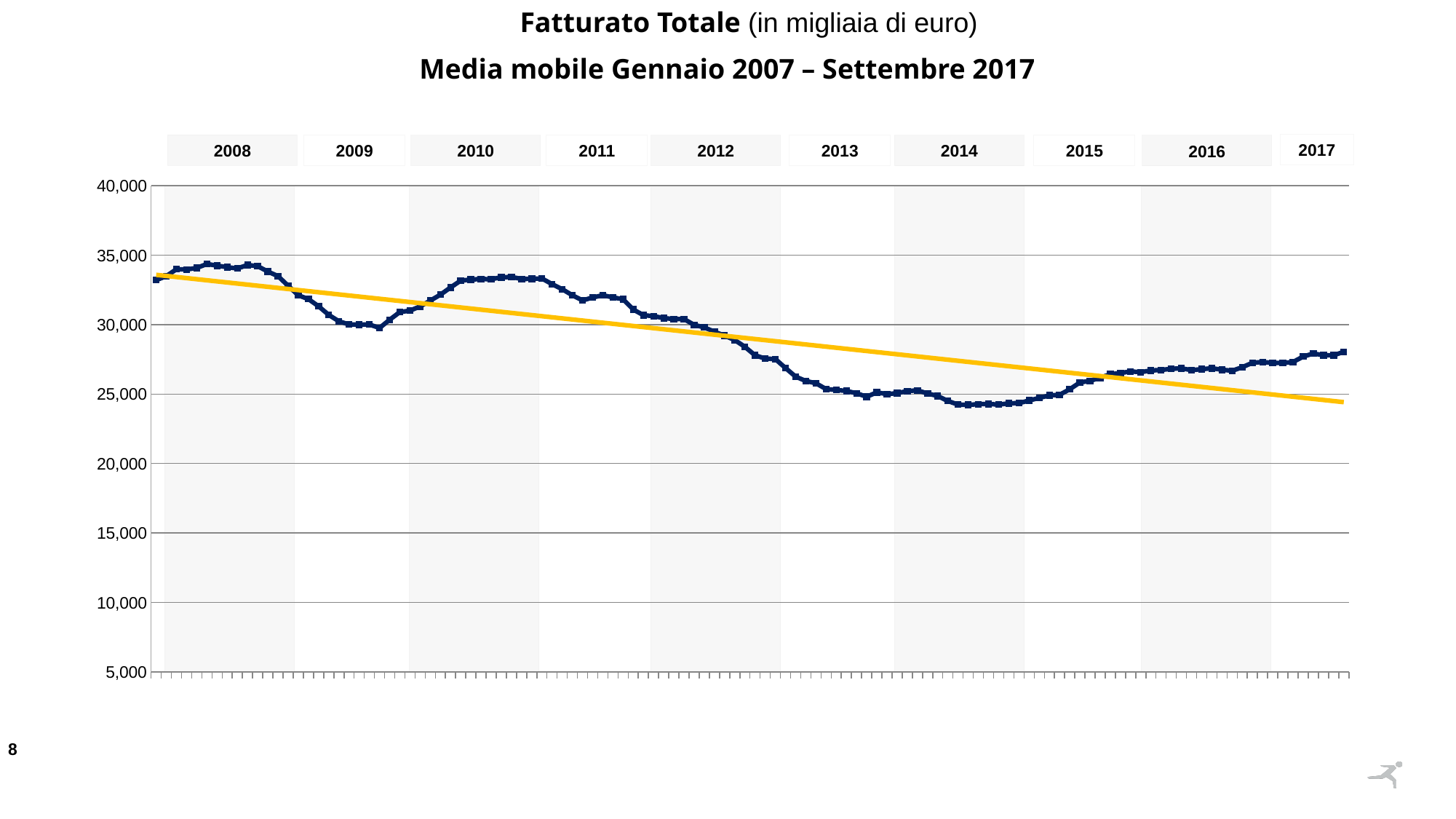
What kind of chart is shown on the slide? line chart Is the value of the yellow trend line at the start of 2008 greater or less than 30,000? greater Is the value of the dark blue line in the middle of 2010 greater or less than 30,000? greater Is the value of the dark blue line at the start of 2008 greater or less than 30,000? greater How many year labels are shown along the top of the chart? 10 In which labelled year does the dark blue line reach its lowest point? 2014 Does the yellow trend line rise or fall from left to right? fall Which year shows the highest values of the dark blue line, 2008 or 2014? 2008 In what unit is the Fatturato Totale expressed according to the chart title? in migliaia di euro Overall, does the dark blue moving-average line rise or fall from 2008 to 2017? fall